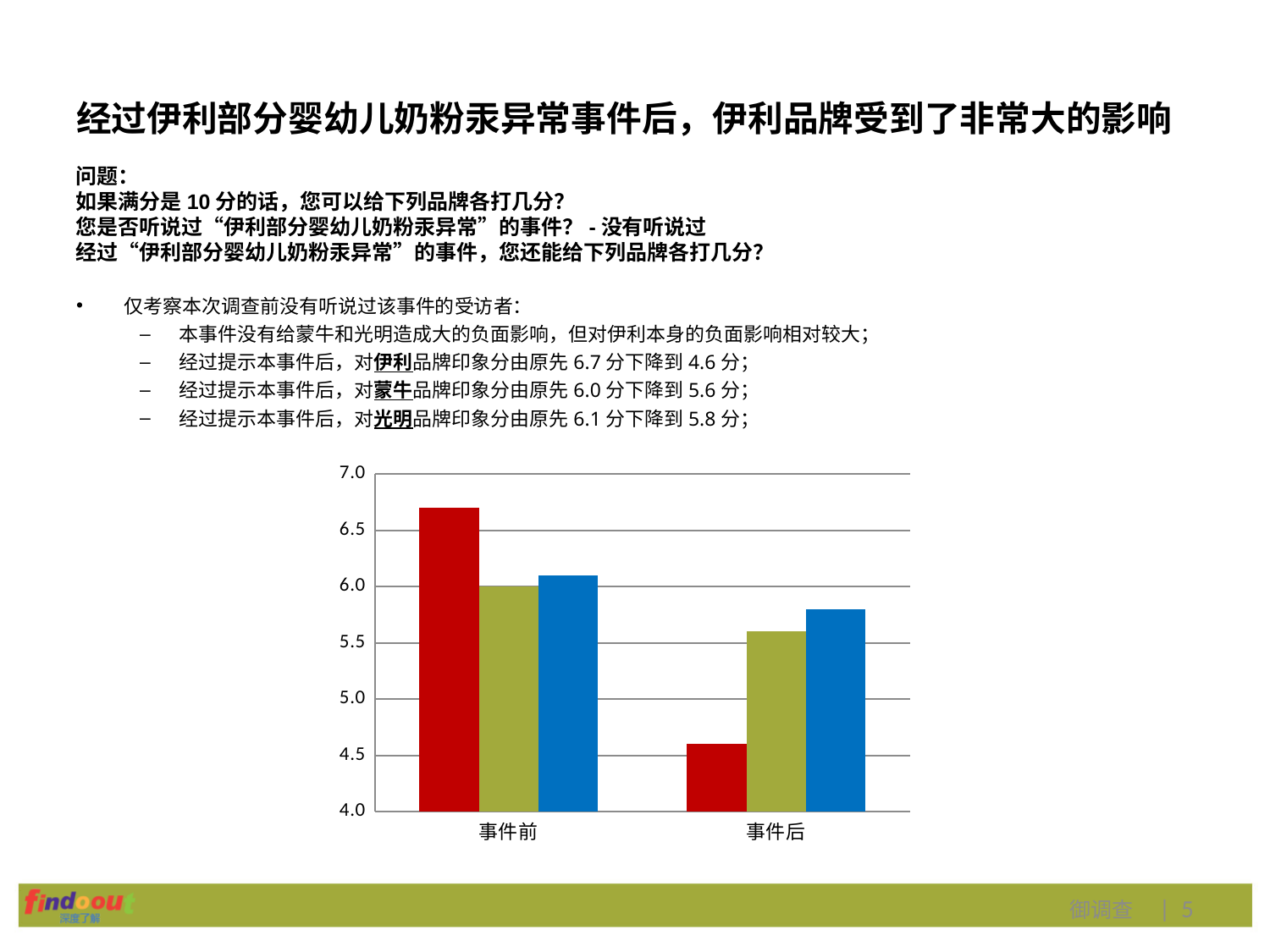
Does the red bar rise or fall from 事件前 to 事件后? fall Which bar is the lowest in the 事件后 group? the red bar Which bar is the highest in the 事件前 group? the red bar How many categories are shown on the x axis of the chart? 2 Is the value of the red bar for 事件后 greater or less than 5.0? less What kind of chart is shown on the slide? bar chart Is the value of the red bar for 事件前 greater or less than 6.5? greater How many bars are plotted in each category group of the chart? 3 Is the value of the blue bar for 事件后 greater or less than 5.5? greater Which is larger: the blue bar for 事件前 or the blue bar for 事件后? the blue bar for 事件前 What are the two category labels on the x axis of the chart? 事件前, 事件后 What is the value of the green bar for 事件前? 6.0